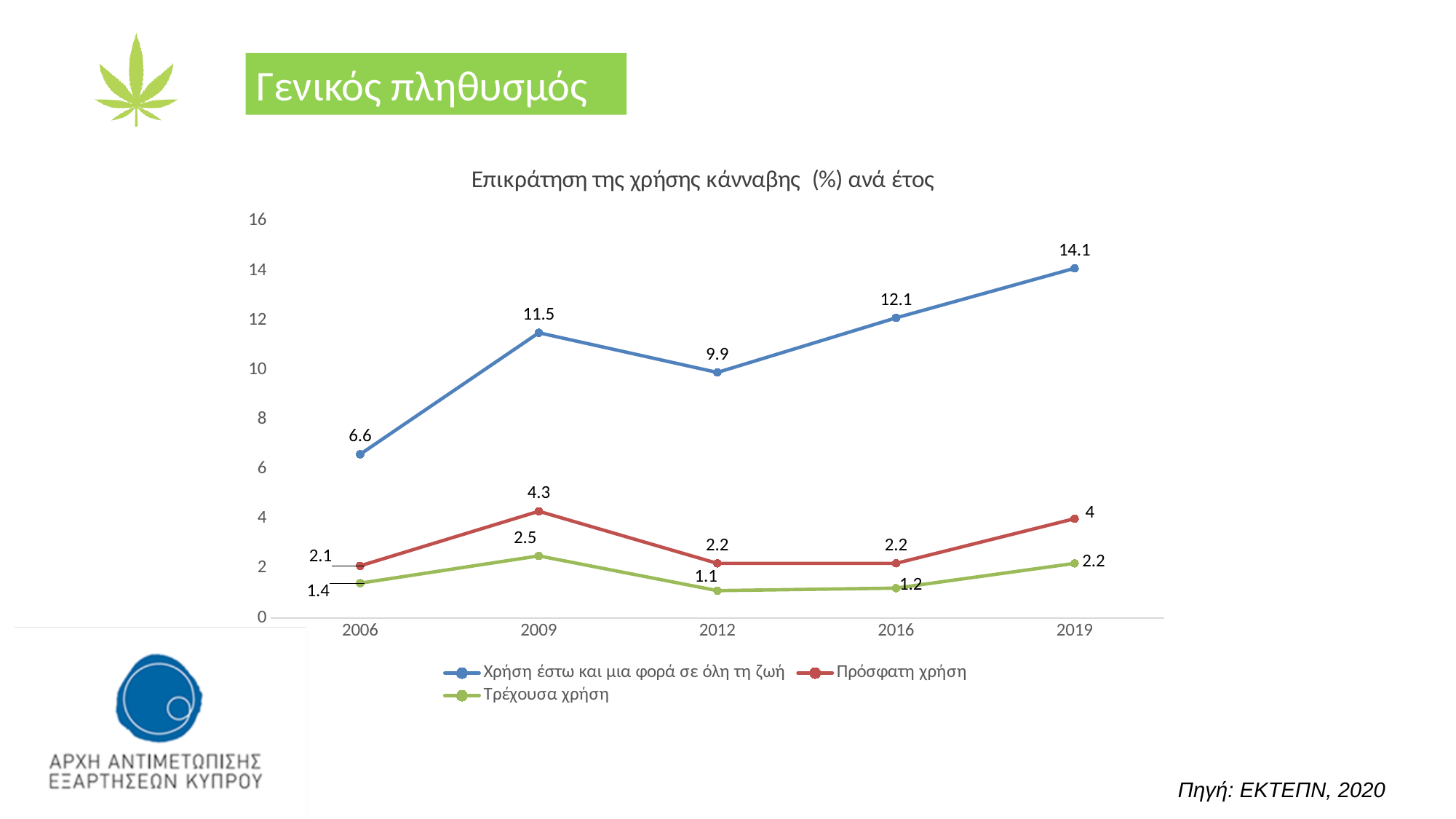
In which year is "Χρήση έστω και μια φορά σε όλη τη ζωή" lowest? 2006 In which year is "Πρόσφατη χρήση" highest? 2009 Is the value for "Χρήση έστω και μια φορά σε όλη τη ζωή" in 2016 greater or less than 10? greater How many series does the legend list? 3 What kind of chart is shown on the slide? line chart How many years are shown on the x axis? 5 What is the difference between the 2019 and 2006 values for "Χρήση έστω και μια φορά σε όλη τη ζωή"? 7.5 What is the value for "Πρόσφατη χρήση" in 2009? 4.3 What is the value for "Τρέχουσα χρήση" in 2012? 1.1 Which is larger: "Πρόσφατη χρήση" in 2019 or "Τρέχουσα χρήση" in 2019? Πρόσφατη χρήση What is the value for "Χρήση έστω και μια φορά σε όλη τη ζωή" in 2019? 14.1 What is the title of the chart? Επικράτηση της χρήσης κάνναβης (%) ανά έτος